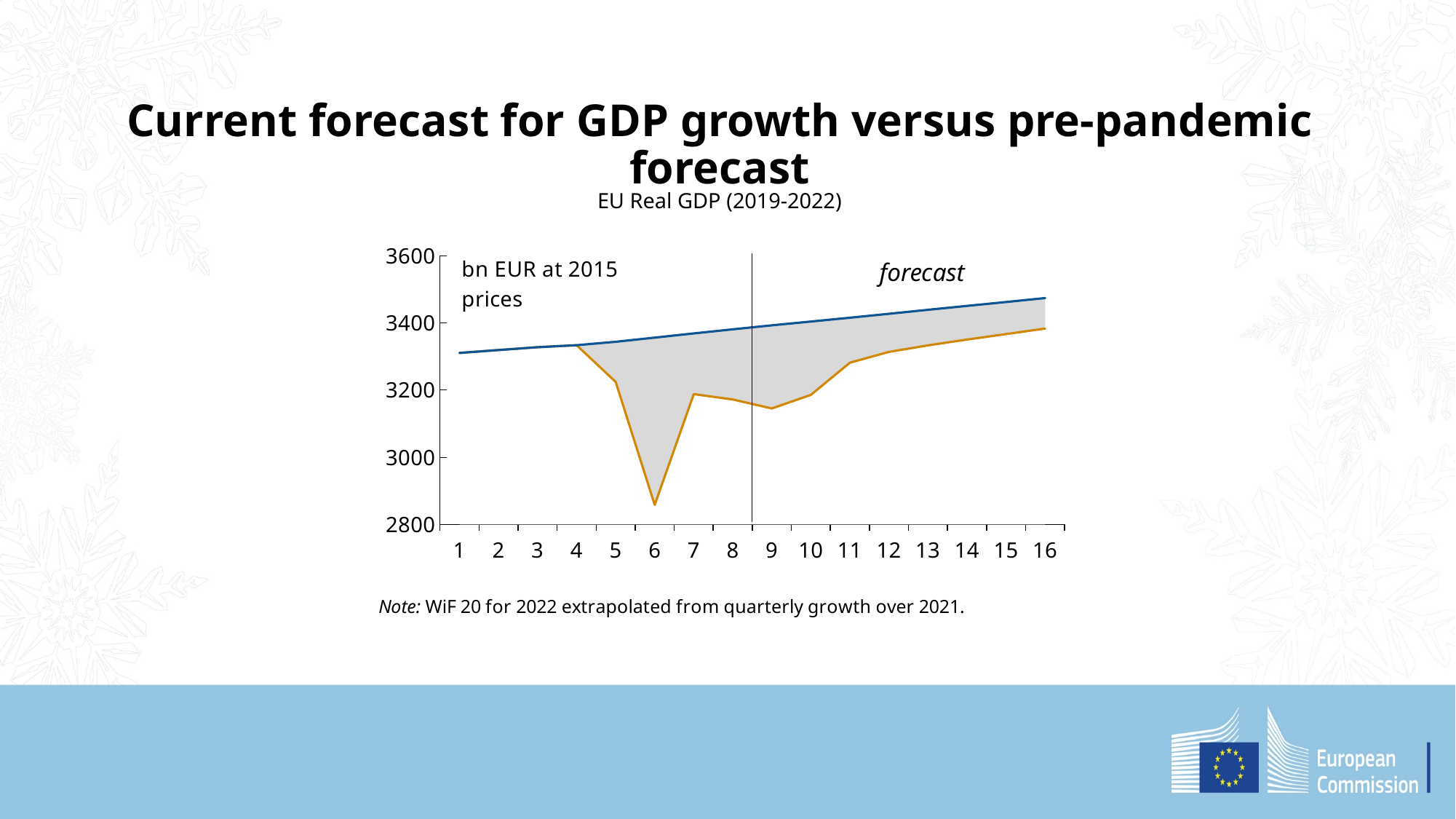
At which x-axis point does the orange line reach its lowest value? 6 What kind of chart is shown on the slide? line chart Does the blue line rise or fall from point 1 to point 16? rise Is the value of the orange line at point 9 greater or less than 3200? less What is the title of the chart? EU Real GDP (2019-2022) Is the value of the orange line at point 12 greater or less than 3200? greater Is the value of the blue line at point 16 greater or less than 3400? greater What unit label is printed inside the chart area? bn EUR at 2015 prices Does the orange line rise or fall from point 6 to point 7? rise How many points are marked along the x axis of the chart? 16 At point 6, which line has the higher value, the blue line or the orange line? the blue line